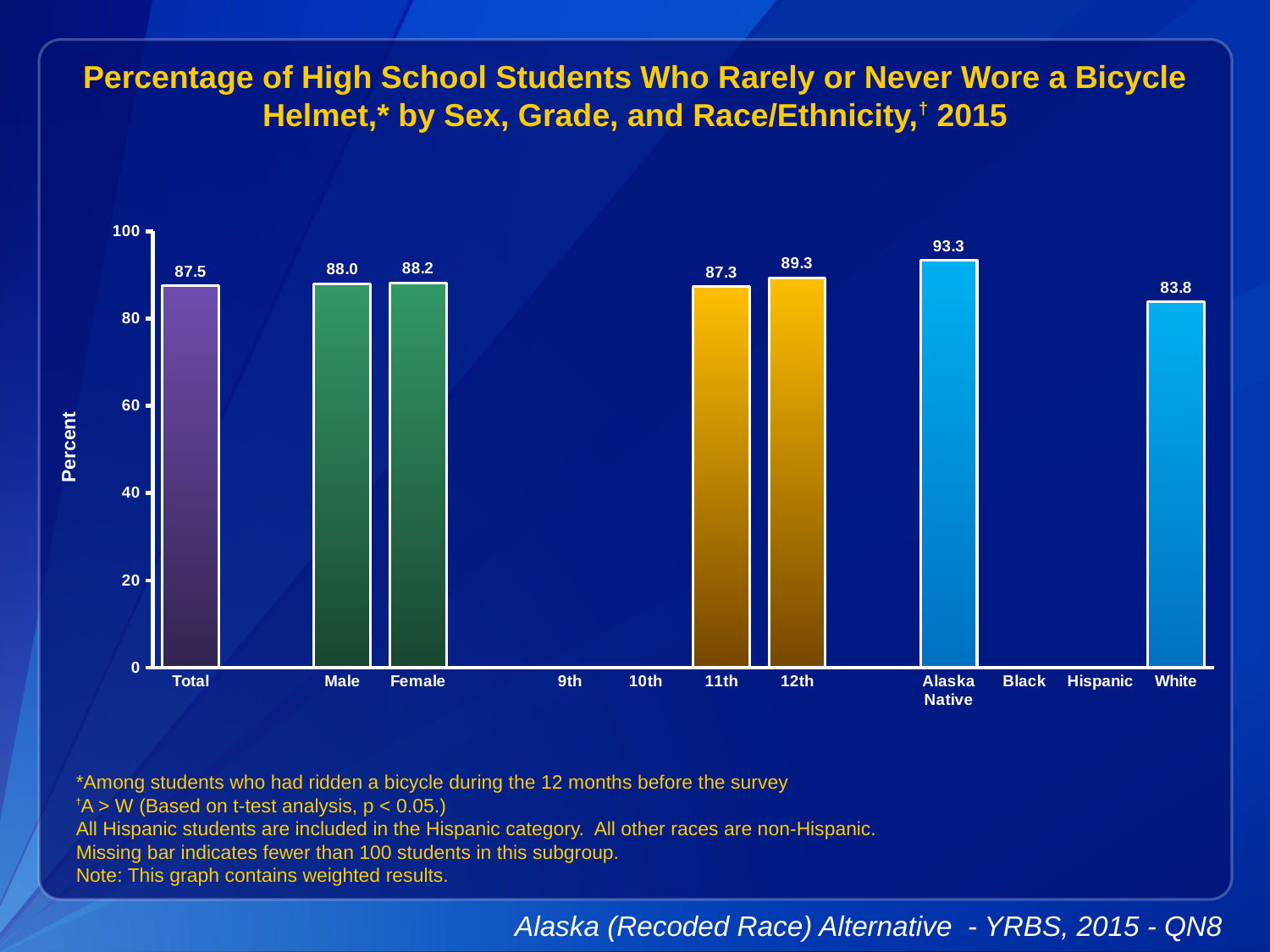
Which is larger, the value for Male or the value for Female? Female What is the value for Female? 88.2 What is the value for White? 83.8 What is the value for 12th grade? 89.3 What is the difference between the values for Alaska Native and White? 9.5 Is the value for Alaska Native greater or less than 80? greater Which category has the highest value? Alaska Native What kind of chart is shown? bar chart What is the value for Total? 87.5 What is the difference between the values for 12th and 11th grade? 2.0 Which category with a plotted bar has the lowest value? White How many categories have a plotted bar? 7